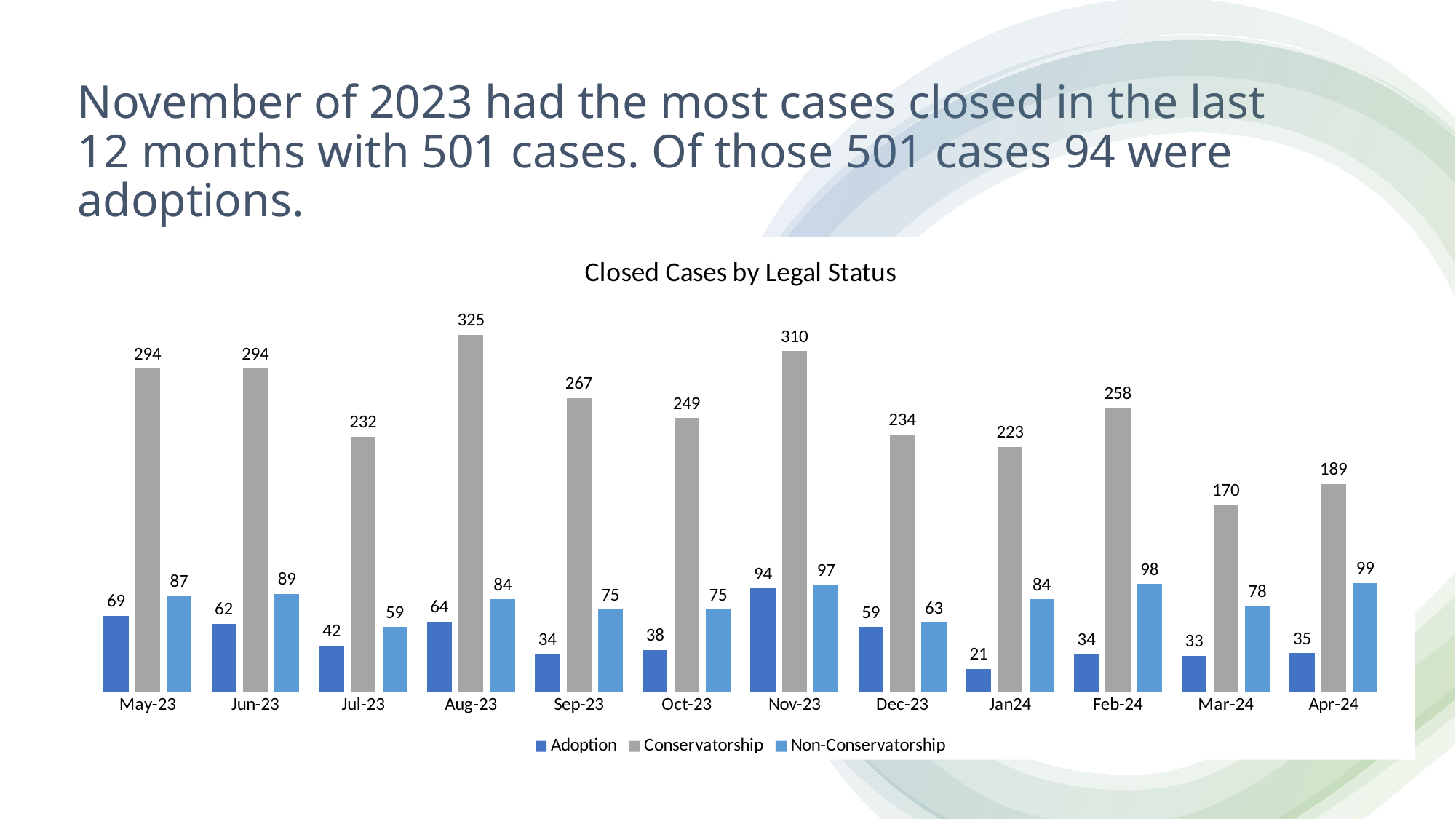
What is the Non-Conservatorship value for Apr-24? 99 Which is larger, the Non-Conservatorship value for Feb-24 or for Nov-23? Feb-24 What kind of chart is shown? Bar chart What is the title of the chart? Closed Cases by Legal Status How many series does the legend list? 3 What is the difference between the Conservatorship values for Aug-23 and Nov-23? 15 Which month has the highest Conservatorship value? Aug-23 Which month has the lowest Adoption value? Jan24 How many months are shown on the x axis? 12 Which month has the lowest Conservatorship value? Mar-24 What is the Conservatorship value for Aug-23? 325 What is the Adoption value for Nov-23? 94